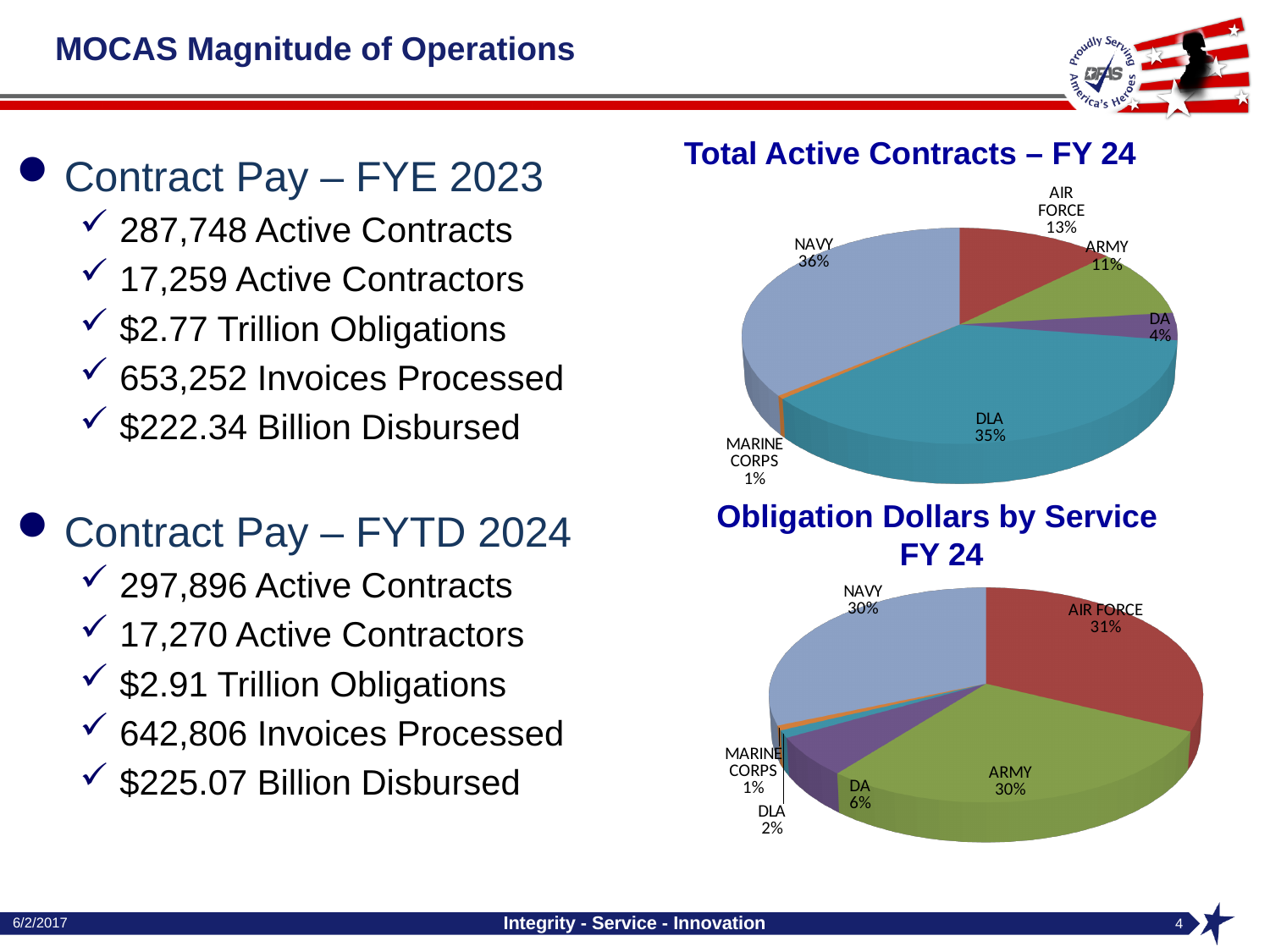
In the Obligation Dollars by Service FY 24 chart, which has a larger share, DA or DLA? DA What type of chart is used for Total Active Contracts – FY 24? Pie chart In the Total Active Contracts – FY 24 chart, what is the difference in percentage points between Air Force and Army? 2 How many slices does the Total Active Contracts – FY 24 pie chart have? 6 In the Obligation Dollars by Service FY 24 chart, what is the difference in percentage points between Army and DLA? 28 In the Obligation Dollars by Service FY 24 chart, which service has the smallest share? Marine Corps In the Total Active Contracts – FY 24 chart, what share of active contracts does the Navy hold? 36% In the Total Active Contracts – FY 24 chart, which has a larger share, Army or DA? Army In the Total Active Contracts – FY 24 chart, which service has the smallest share? Marine Corps In the Total Active Contracts – FY 24 chart, what percentage is shown for DLA? 35% In the Obligation Dollars by Service FY 24 chart, what percentage is shown for Air Force? 31% In the Obligation Dollars by Service FY 24 chart, what share is shown for DA? 6%